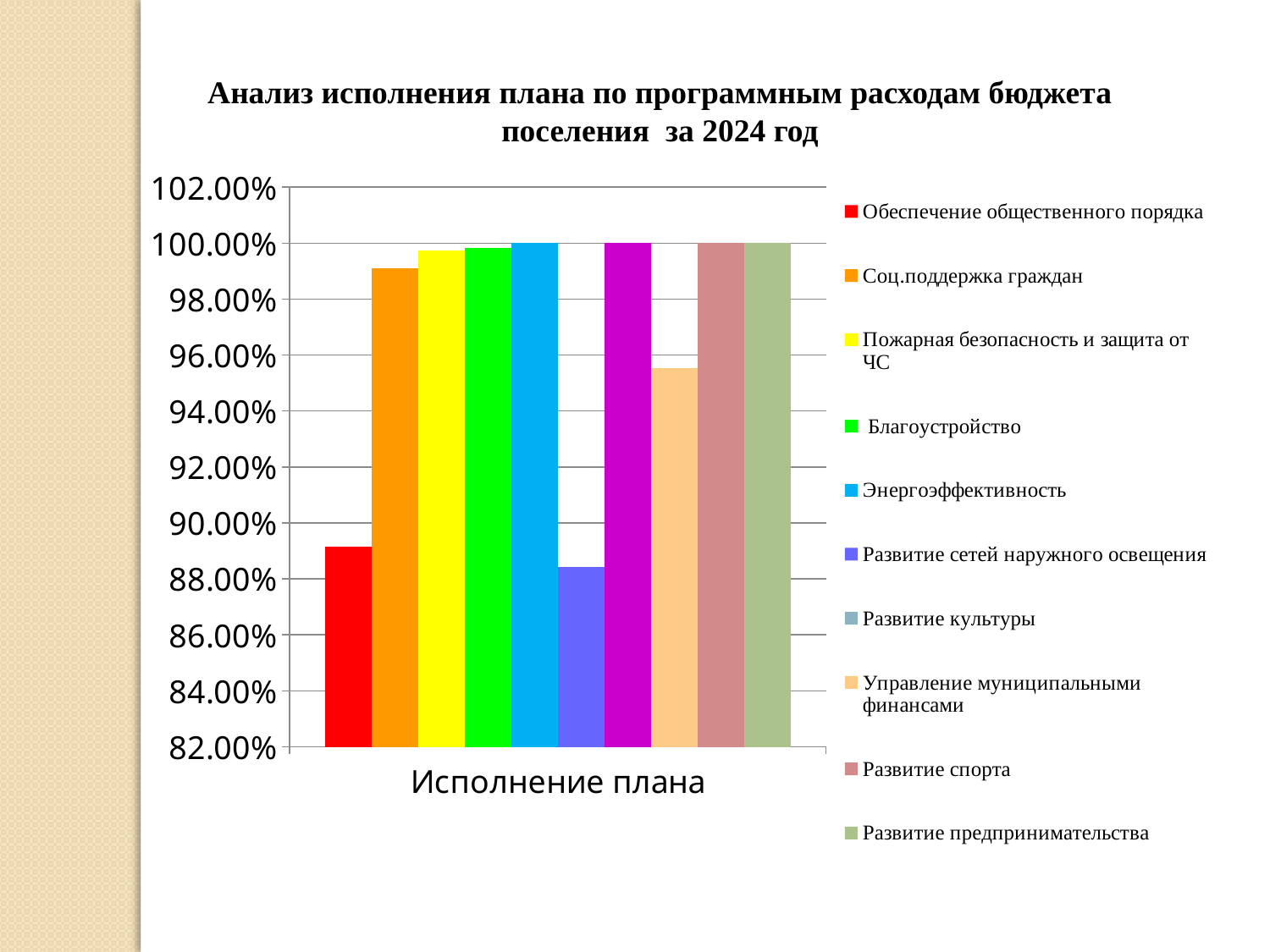
How many series does the legend list? 10 Is the value for Управление муниципальными финансами greater or less than 96.00%? less Is the value for Энергоэффективность greater or less than 98.00%? greater Which is larger, the value for Управление муниципальными финансами or the value for Развитие сетей наружного освещения? Управление муниципальными финансами What is the category label on the x axis? Исполнение плана Is the value for Соц.поддержка граждан greater or less than 98.00%? greater How many categories are shown on the x axis? 1 What is the title of the chart? Анализ исполнения плана по программным расходам бюджета поселения за 2024 год What kind of chart is shown on the slide? bar chart Which is larger, the value for Соц.поддержка граждан or the value for Обеспечение общественного порядка? Соц.поддержка граждан